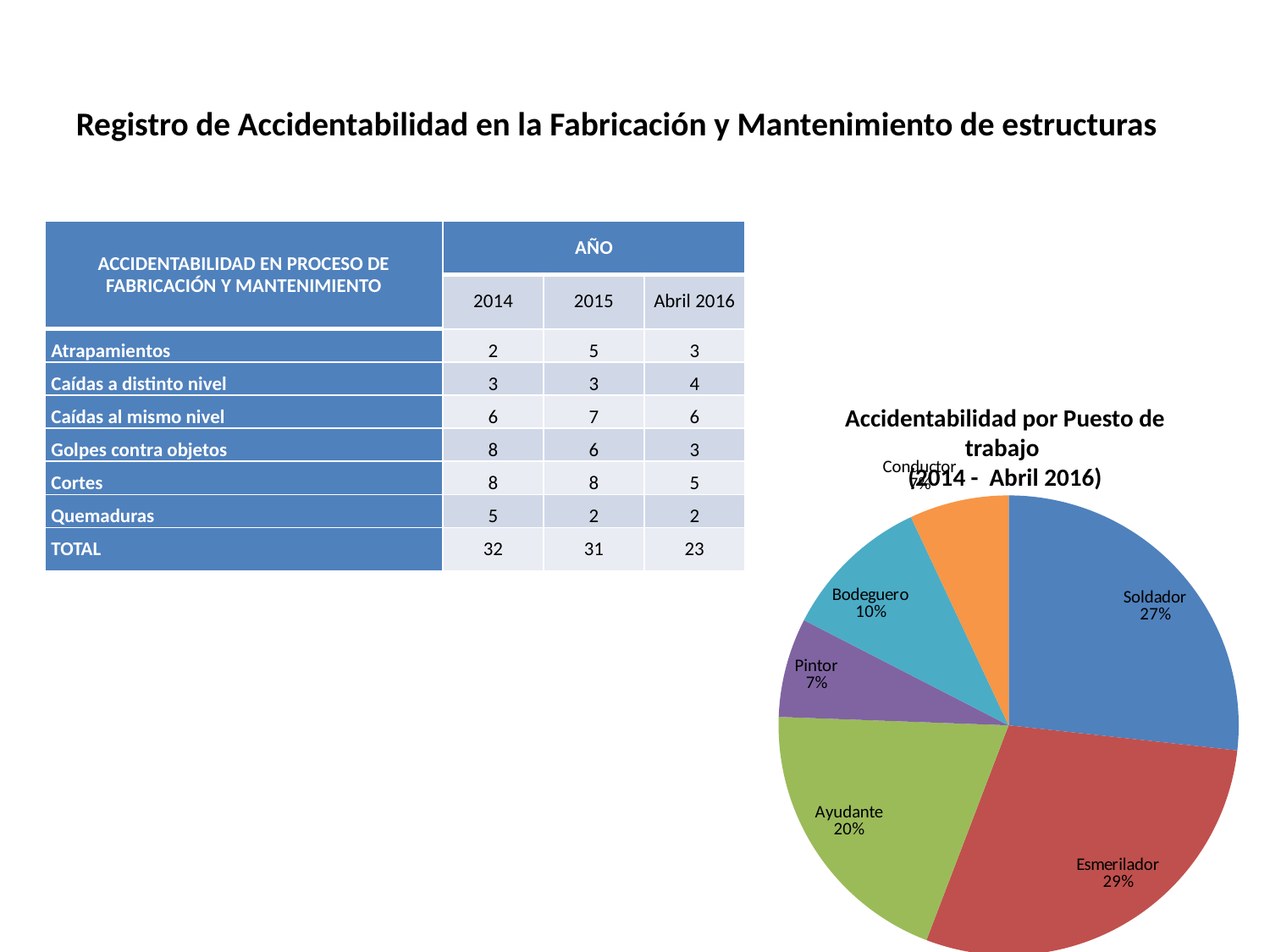
What share of the pie does Pintor represent? 7% What kind of chart is shown on the slide? pie chart Which is larger in the pie chart, Soldador or Ayudante? Soldador Which job position has the largest slice of the pie? Esmerilador How many slices does the pie chart have? 6 What share of the pie does Bodeguero represent? 10% What is the title of the pie chart? Accidentabilidad por Puesto de trabajo (2014 - Abril 2016) What share of the pie does Esmerilador represent? 29% What share of the pie does Soldador represent? 27% What is the difference in percentage points between Esmerilador and Soldador? 2% What share of the pie does Ayudante represent? 20% What is the difference in percentage points between Ayudante and Bodeguero? 10%